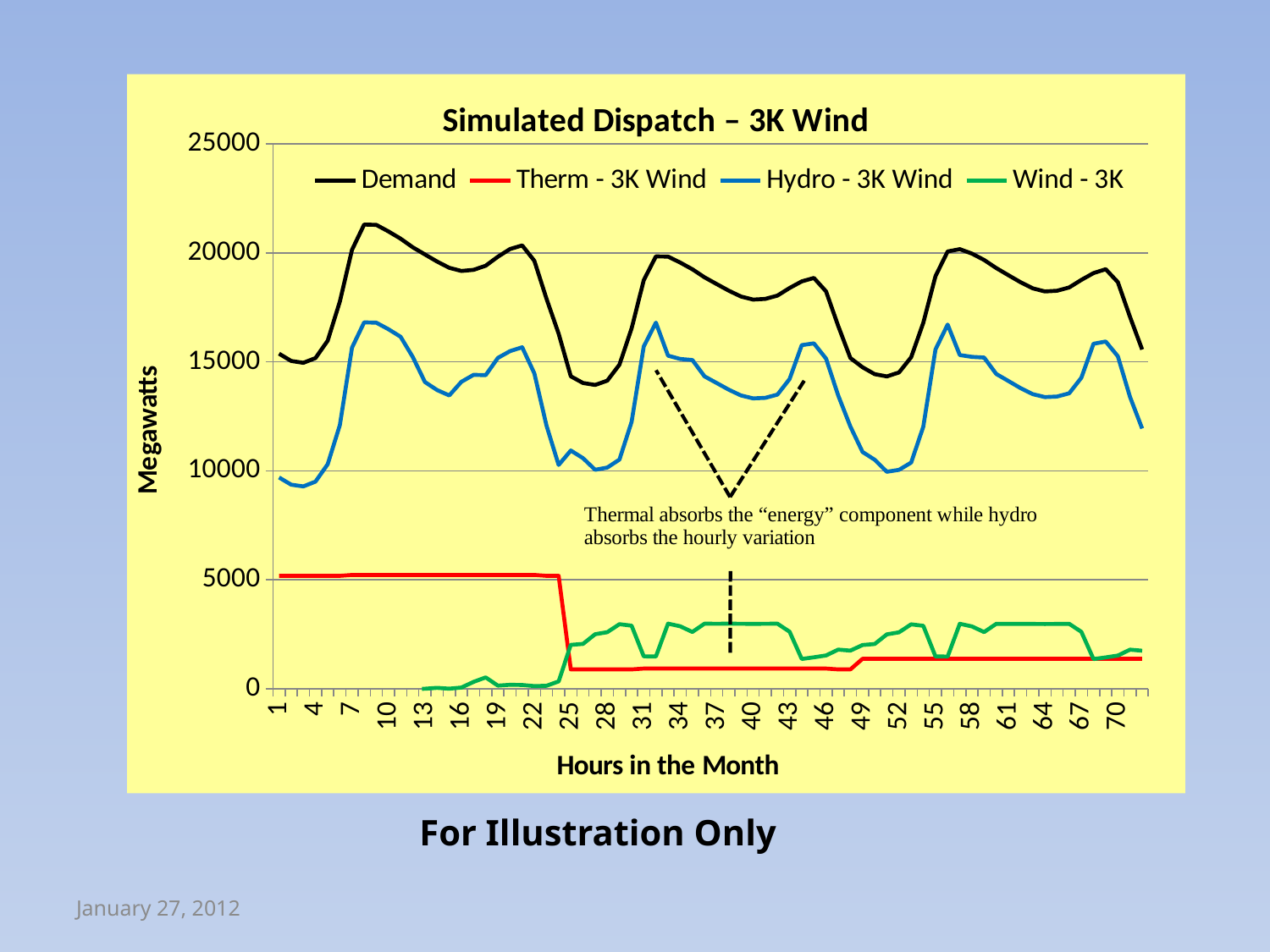
How many series does the legend list? 4 What is the label on the vertical axis? Megawatts Is the value of Therm - 3K Wind at hour 37 greater or less than 5000? less Is the peak value of Demand around hour 8 greater or less than 20000? greater Does the Therm - 3K Wind series rise or fall between hour 22 and hour 25? fall Which series has the highest values across the whole chart? Demand At hour 37, which is larger: Therm - 3K Wind or Wind - 3K? Wind - 3K What is the title of the chart? Simulated Dispatch – 3K Wind Is the value of Demand at hour 25 greater or less than 15000? less At hour 1, which is larger: Therm - 3K Wind or Wind - 3K? Therm - 3K Wind What kind of chart is shown on the slide? line chart